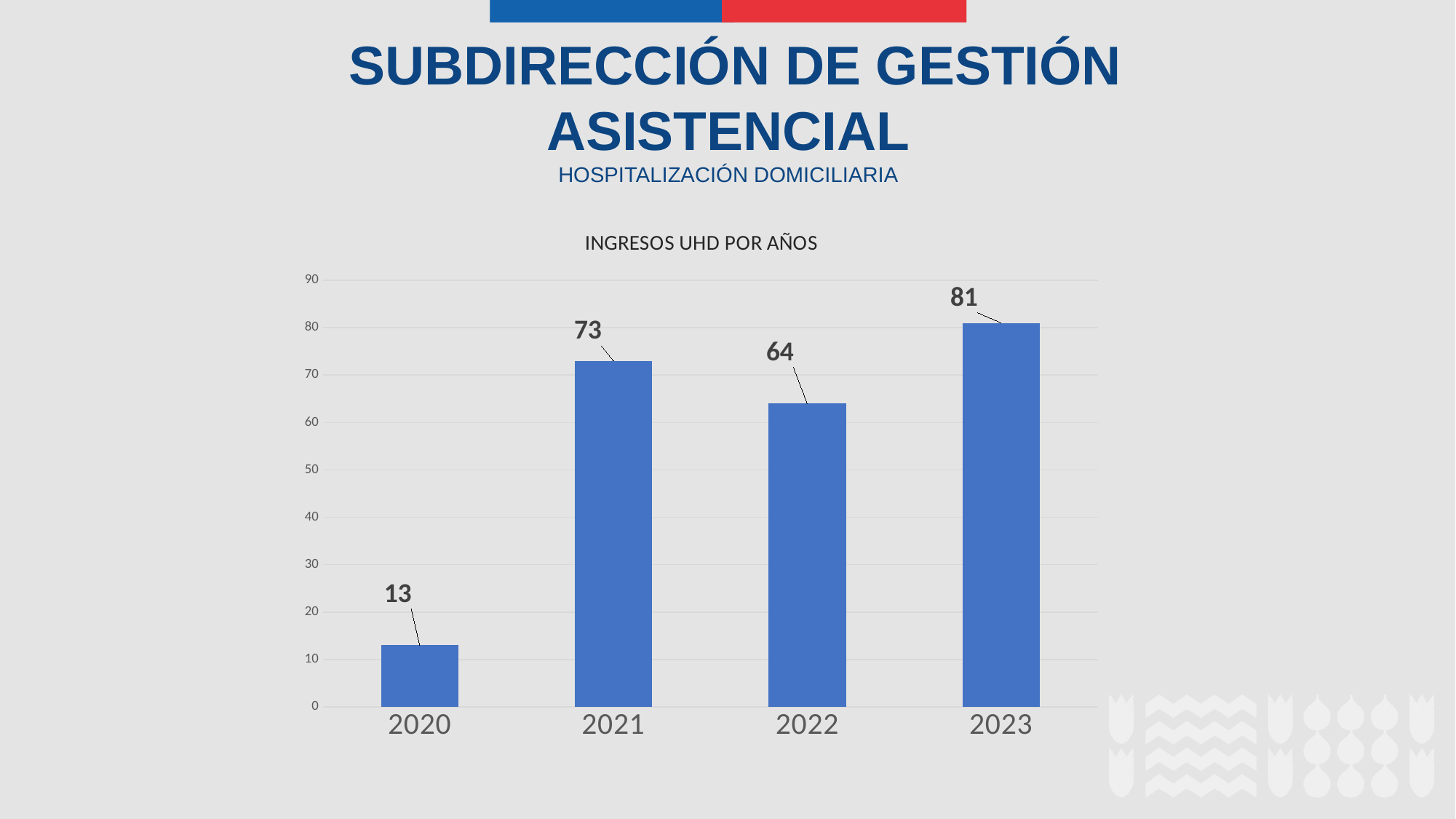
What is the title of the chart? INGRESOS UHD POR AÑOS What is the value for 2021? 73 How many years are shown on the x axis? 4 Which year has the lowest value? 2020 Which is larger, the value for 2021 or the value for 2022? 2021 What is the value for 2023? 81 What kind of chart is shown on the slide? bar chart What is the value for 2020? 13 Is the value for 2021 greater or less than 70? greater Which year has the highest value? 2023 What is the value for 2022? 64 What is the difference between the values for 2023 and 2022? 17